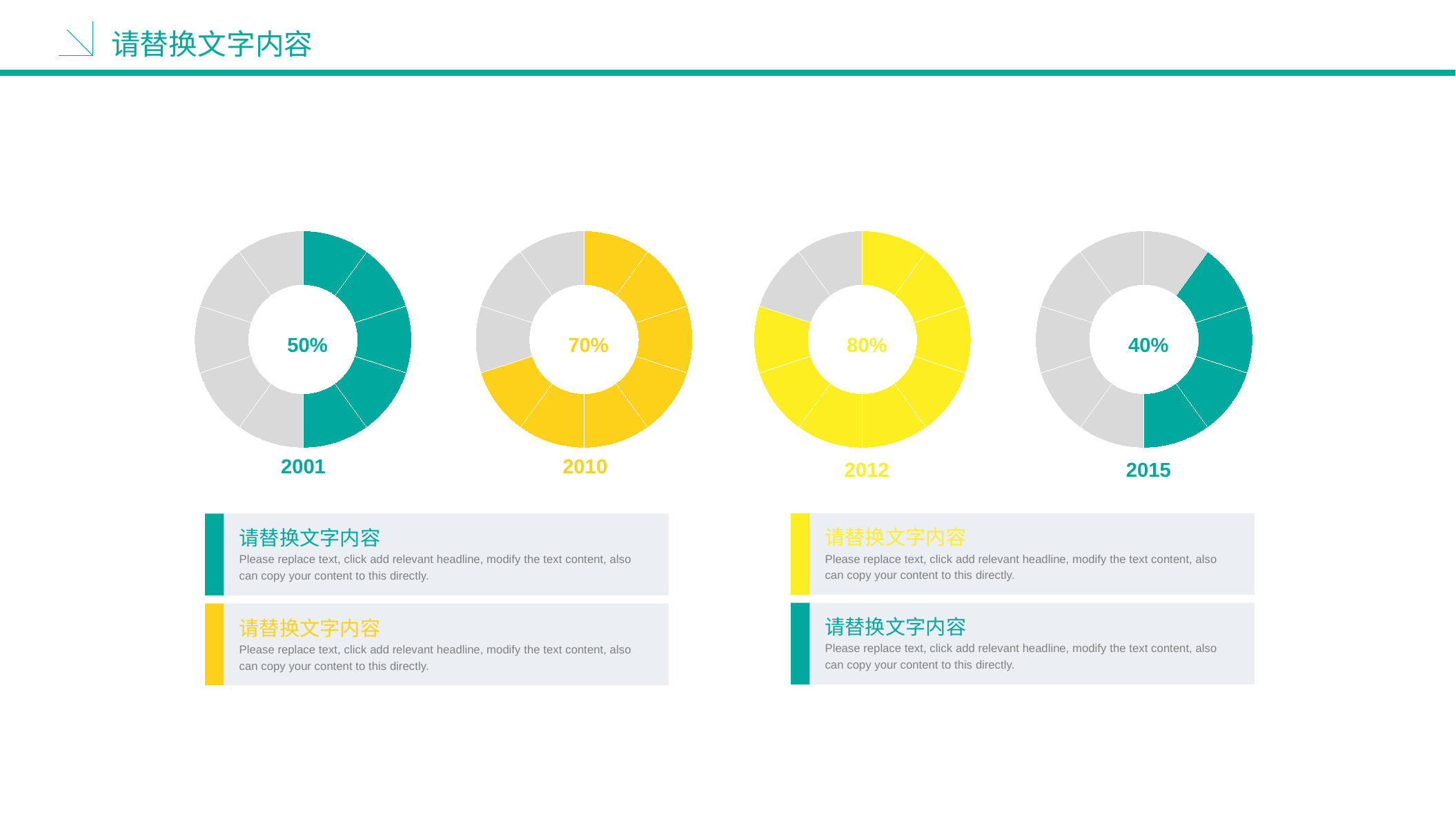
What percentage is shown in the centre of the donut chart labelled 2001? 50% What colour is the filled portion of the donut chart labelled 2015? Teal Reading the four donut charts from left to right (2001, 2010, 2012, 2015), does the percentage rise or fall between 2012 and 2015? Fall What percentage is shown in the centre of the donut chart labelled 2012? 80% What percentage is shown in the centre of the donut chart labelled 2010? 70% What is the difference between the percentage in the 2012 donut chart and the percentage in the 2001 donut chart? 30% What kind of chart is used for each of the four year values on the slide? Donut chart Across the four donut charts, which year shows the lowest percentage? 2015 How many donut charts are shown on the slide? 4 What percentage is shown in the centre of the donut chart labelled 2015? 40% Which is larger, the percentage in the 2010 donut chart or the percentage in the 2015 donut chart? 2010 Across the four donut charts, which year shows the highest percentage? 2012